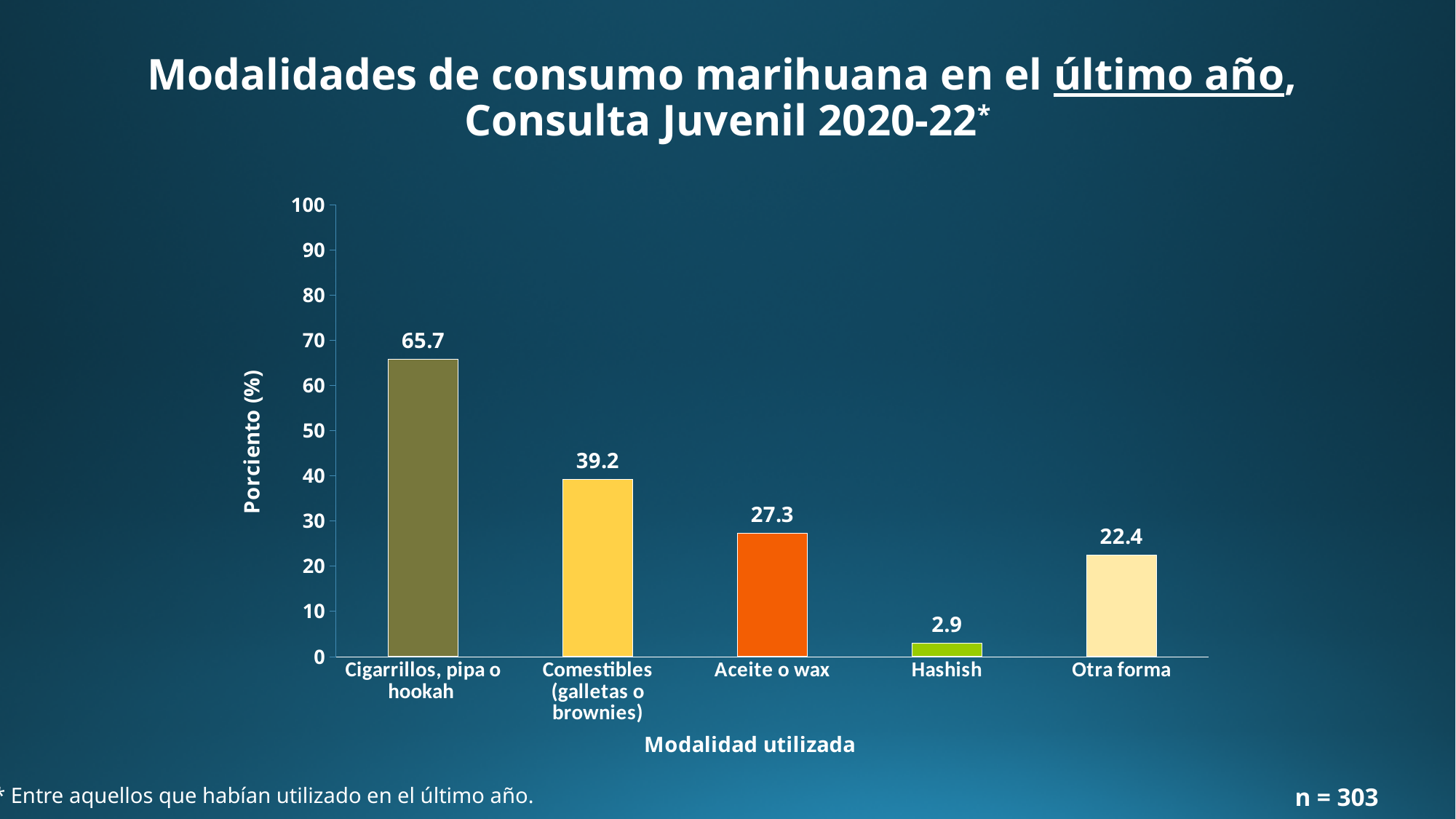
What is the difference between the values for Cigarrillos, pipa o hookah and Comestibles (galletas o brownies)? 26.5 What kind of chart is shown on the slide? Bar chart What is the value for Otra forma? 22.4 How many categories are shown on the x axis? 5 Which is larger, the value for Aceite o wax or the value for Otra forma? Aceite o wax Which category has the highest value? Cigarrillos, pipa o hookah What is the value for Hashish? 2.9 What is the value for Cigarrillos, pipa o hookah? 65.7 Which category has the lowest value? Hashish What is the label of the y axis? Porciento (%) What is the value for Comestibles (galletas o brownies)? 39.2 What is the value for Aceite o wax? 27.3